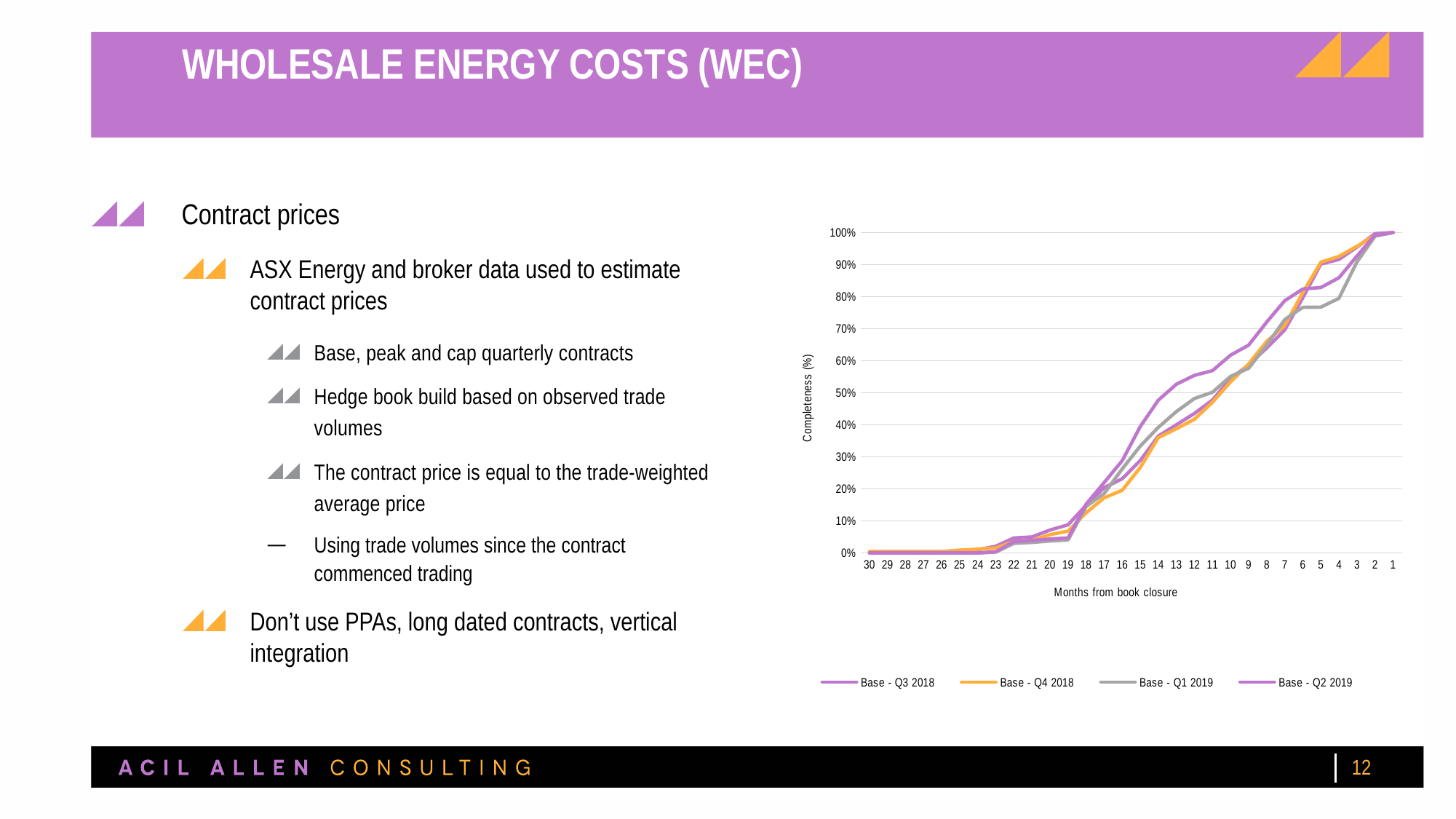
How many months are marked along the x axis of the chart? 30 Is the value for Base - Q1 2019 at 5 months from book closure greater or less than 80%? less Do the completeness values rise or fall moving from left to right along the x axis (from 30 months to 1 month from book closure)? rise What is the title of the chart's x axis? Months from book closure What kind of chart is shown on the slide? line chart Is the value for Base - Q4 2018 at 5 months from book closure greater or less than 80%? greater How many series does the chart legend list? 4 What completeness value do all series reach at 1 month from book closure? 100% Is the value for Base - Q4 2018 at 13 months from book closure greater or less than 50%? less What is the title of the chart's y axis? Completeness (%)